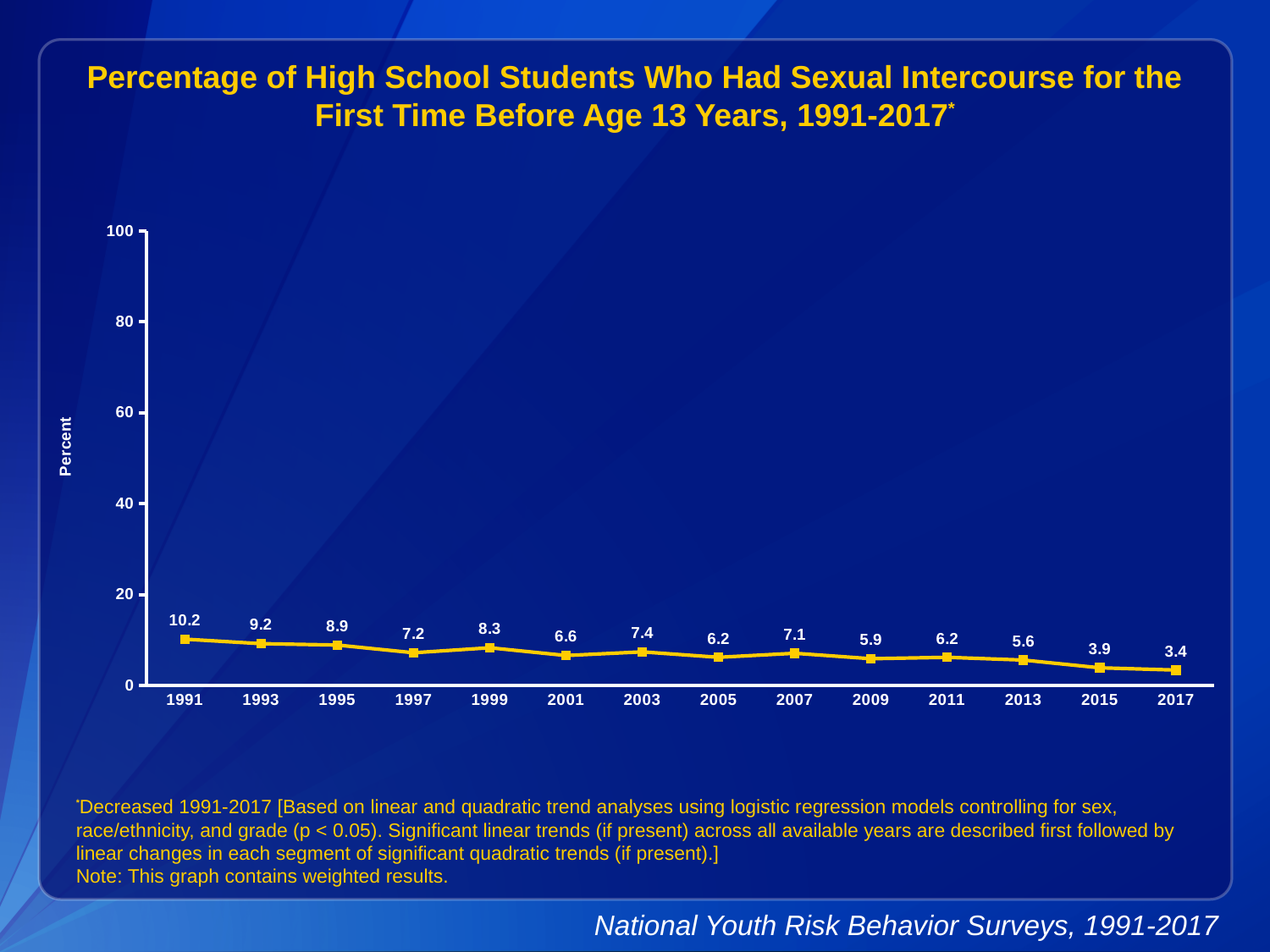
What is the value for 1991? 10.2 What kind of chart is shown? line chart Do the values generally rise or fall from 1991 to 2017? fall What is the difference between the values for 1991 and 2017? 6.8 What is the value for 2003? 7.4 Is the value for 1991 greater or less than 20? less How many years are plotted on the chart? 14 What is the label on the y axis? Percent What is the value for 2017? 3.4 Which year has the highest value? 1991 Which is larger, the value for 1999 or the value for 2001? 1999 Which year has the lowest value? 2017